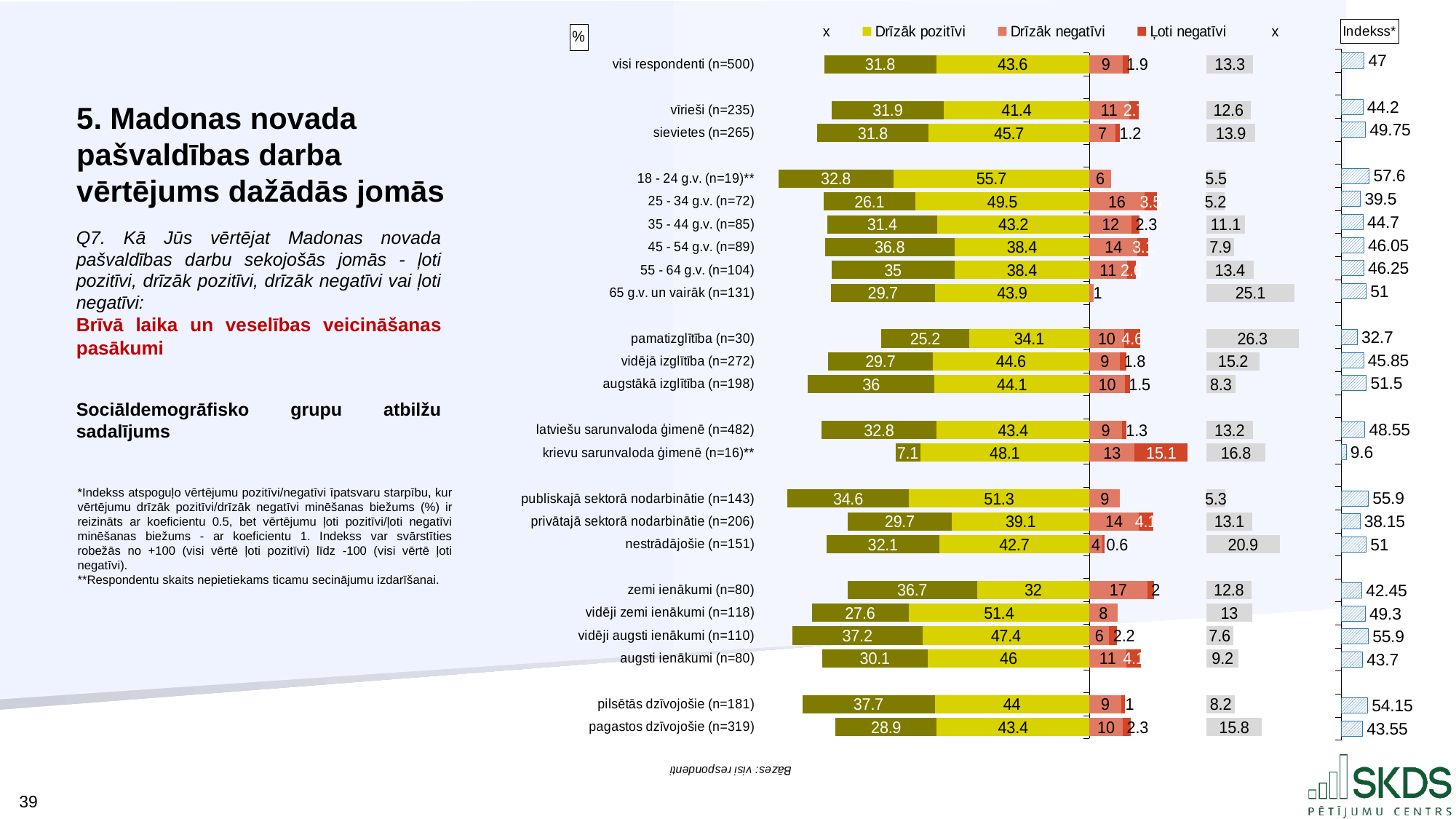
What is the 'Ļoti negatīvi' value for 'krievu sarunvaloda ģimenē (n=16)**'? 15.1 Which group has the highest Indekss* value? 18 - 24 g.v. (n=19)** What is the 'Drīzāk pozitīvi' value for 'visi respondenti (n=500)'? 43.6 Which group has the highest 'Drīzāk pozitīvi' value? 18 - 24 g.v. (n=19)** How many respondent groups (categories) are plotted in the chart? 23 What is the Indekss* value for '18 - 24 g.v. (n=19)**'? 57.6 What kind of chart is shown on the slide? Stacked bar chart What is the Indekss* value for 'pilsētās dzīvojošie (n=181)'? 54.15 What is the 'Drīzāk negatīvi' value for 'zemi ienākumi (n=80)'? 17 Which has a larger 'Drīzāk pozitīvi' value, 'vīrieši (n=235)' or 'sievietes (n=265)'? sievietes (n=265) Which group has the lowest Indekss* value? krievu sarunvaloda ģimenē (n=16)** What is the difference between the Indekss* values of 'sievietes (n=265)' and 'vīrieši (n=235)'? 5.55